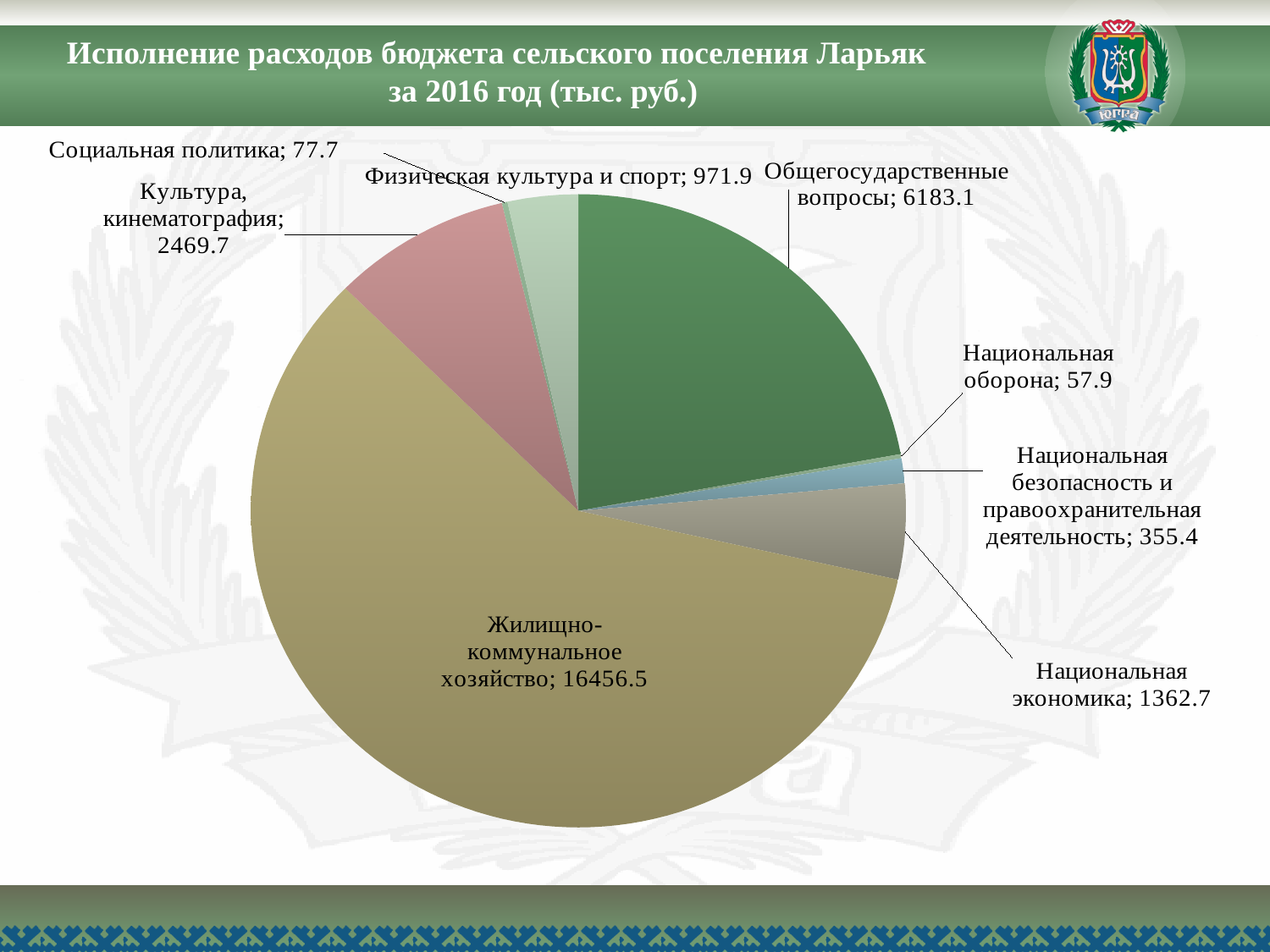
What is the title of the chart on the slide? Исполнение расходов бюджета сельского поселения Ларьяк за 2016 год (тыс. руб.) Which is larger: Национальная безопасность и правоохранительная деятельность or Социальная политика? Национальная безопасность и правоохранительная деятельность What is the difference between Общегосударственные вопросы and Культура, кинематография? 3713.4 What is the value for Жилищно-коммунальное хозяйство? 16456.5 What is the value for Общегосударственные вопросы? 6183.1 What is the value for Культура, кинематография? 2469.7 What type of chart is shown on the slide? pie chart Which category has the smallest value? Национальная оборона What is the difference between Национальная экономика and Физическая культура и спорт? 390.8 Which category has the largest slice of the pie? Жилищно-коммунальное хозяйство How many categories are shown in the pie chart? 8 What is the value for Национальная оборона? 57.9